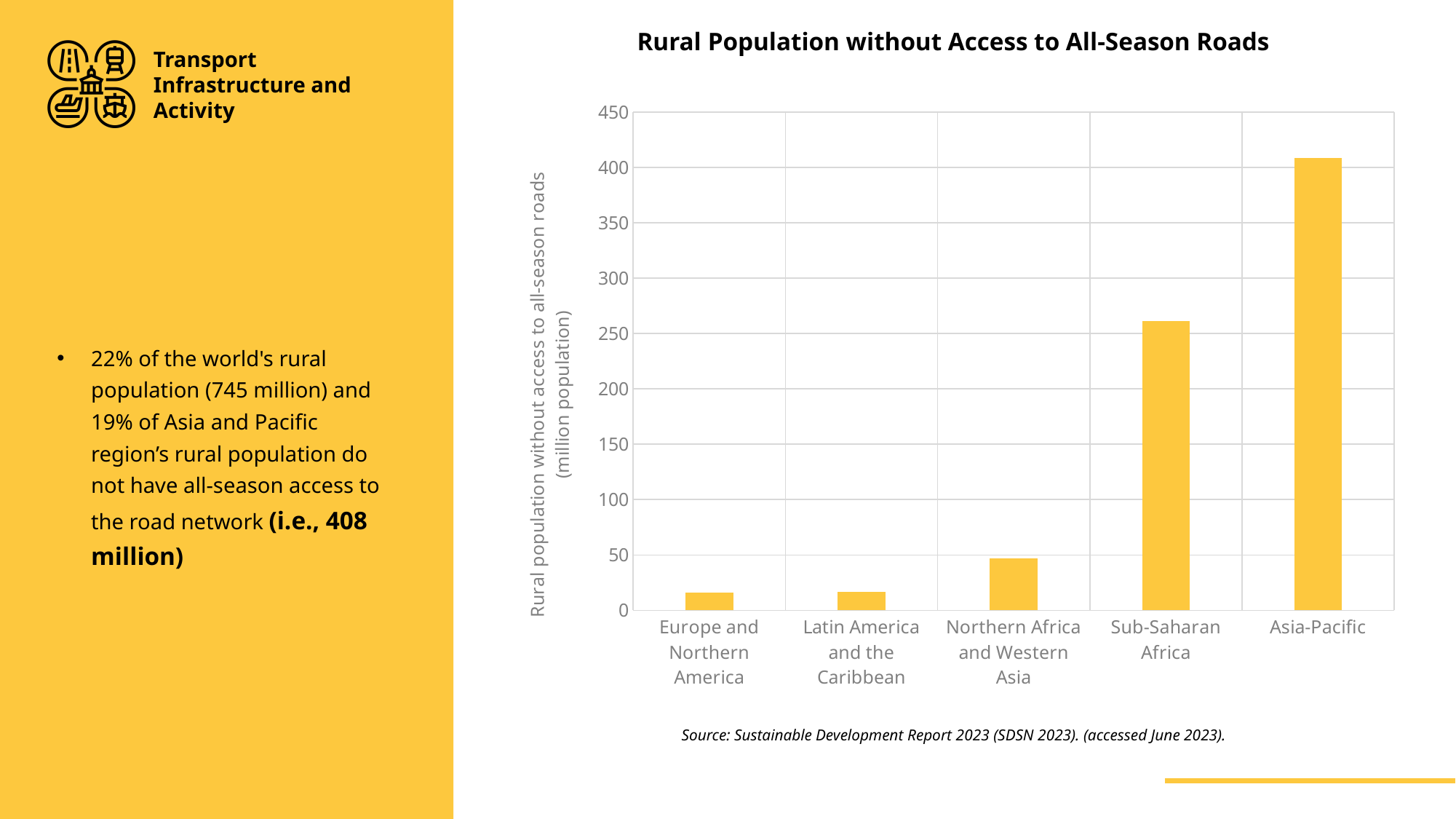
Is the value for Sub-Saharan Africa greater or less than 200? greater What kind of chart is shown on the slide? bar chart Do the bar values generally rise or fall from left to right across the regions? rise Is the value for Latin America and the Caribbean greater or less than 50? less What is the title of the chart? Rural Population without Access to All-Season Roads What unit is given in the y-axis label of the chart? million population Is the value for Asia-Pacific greater or less than 350? greater How many regions are plotted in the chart? 5 Which has a larger value, Sub-Saharan Africa or Northern Africa and Western Asia? Sub-Saharan Africa Which region has the highest rural population without access to all-season roads? Asia-Pacific